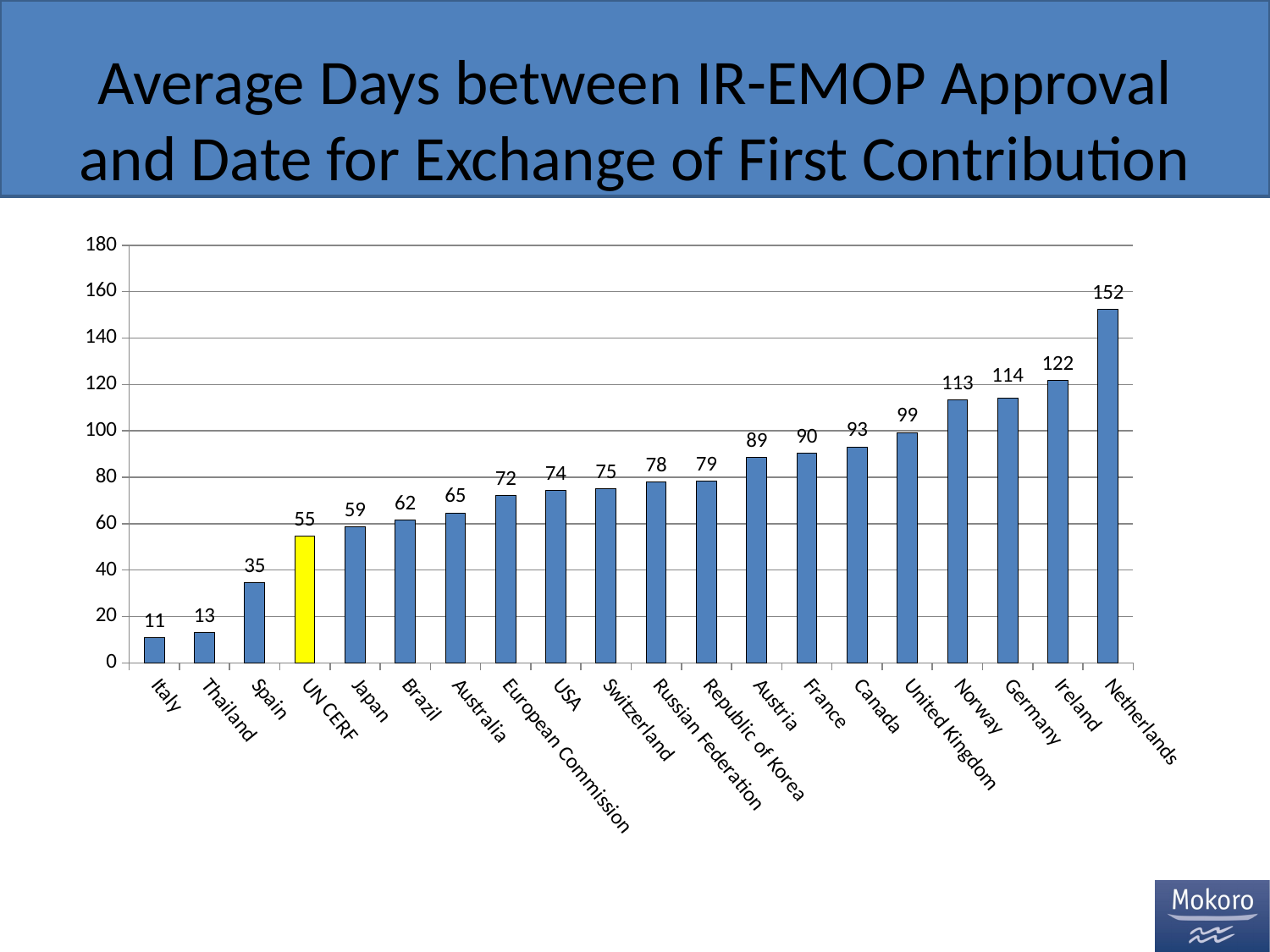
What is the difference between the values for Netherlands and Italy? 141 Do the values rise or fall from left to right along the x axis? rise What kind of chart is shown on the slide? bar chart What is the value for UN CERF? 55 Which bar is coloured yellow instead of blue? UN CERF Which is larger, the value for Canada or the value for Austria? Canada How many categories are shown on the x axis? 20 What is the value for Switzerland? 75 Which category has the lowest value? Italy Is the value for Norway greater or less than 100? greater What is the difference between the values for Germany and Norway? 1 Which category has the highest value? Netherlands